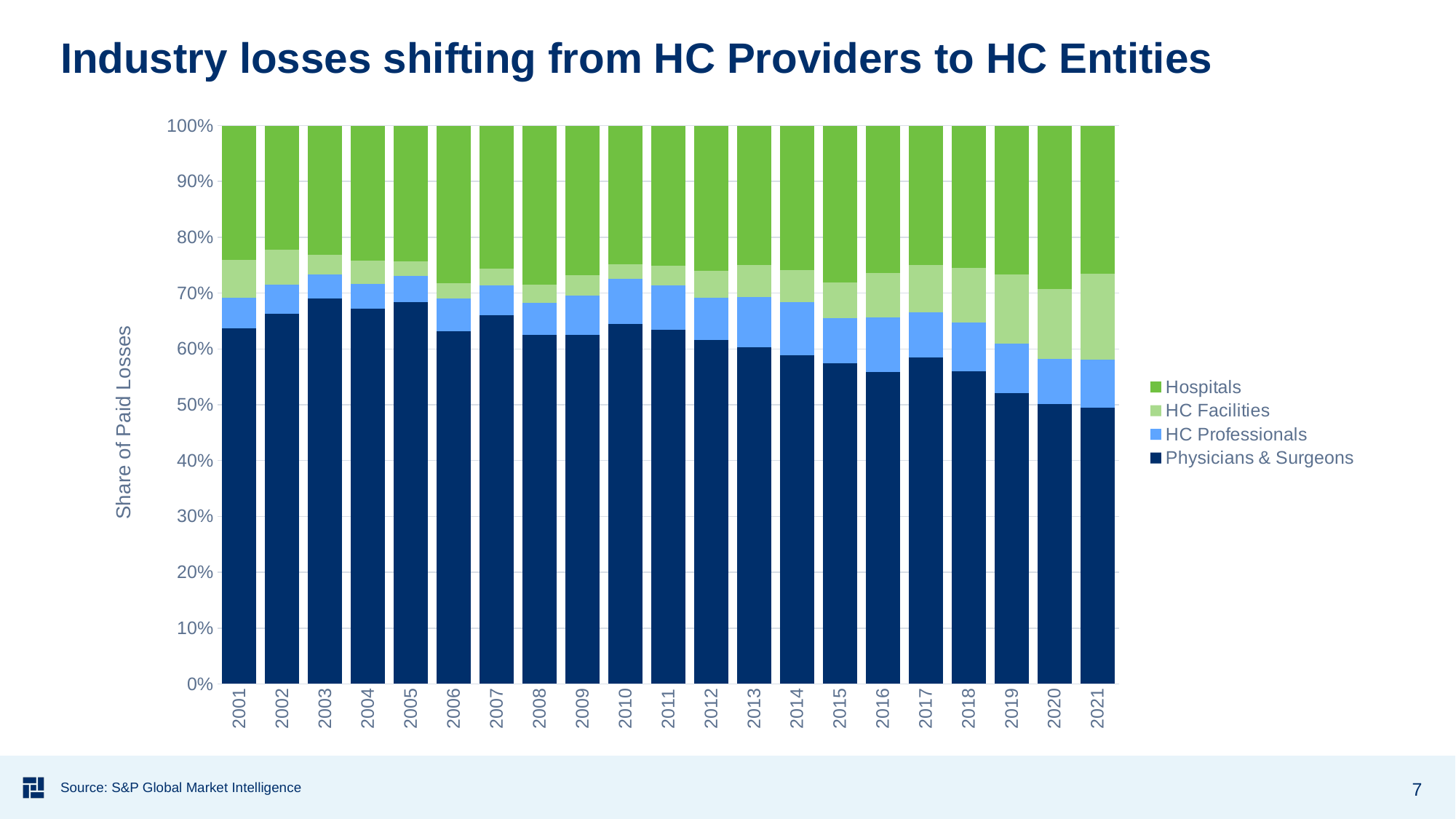
What kind of chart is shown on the slide? Stacked bar chart Is the Physicians & Surgeons share of paid losses in 2010 greater or less than 60%? greater How many series does the chart's legend list? 4 What is the label on the chart's vertical axis? Share of Paid Losses What is the total of each stacked bar in the chart? 100% Which year has the larger Physicians & Surgeons share of paid losses, 2001 or 2021? 2001 How many years are shown along the x axis of the chart? 21 Is the Physicians & Surgeons share of paid losses in 2001 greater or less than 60%? greater Does the Physicians & Surgeons share of paid losses generally rise or fall from 2001 to 2021? fall Which series is listed first in the chart's legend? Hospitals Is the Physicians & Surgeons share of paid losses in 2016 greater or less than 60%? less